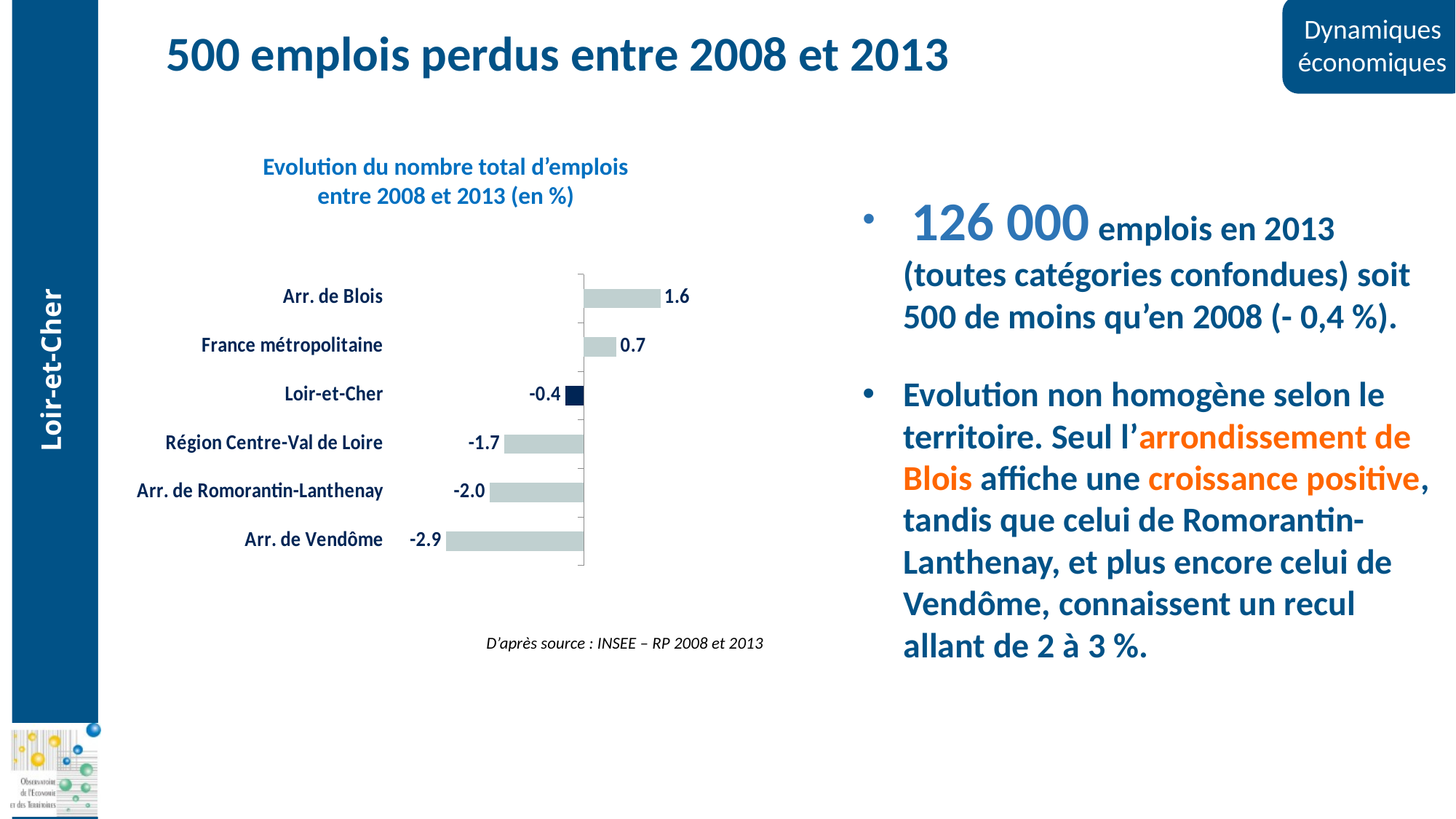
Which has the larger value, France métropolitaine or Loir-et-Cher? France métropolitaine What is the difference between the values for Arr. de Romorantin-Lanthenay and Arr. de Vendôme? 0.9 Which category has the highest value in the chart? Arr. de Blois How many categories are shown in the chart? 6 What is the title of the chart? Evolution du nombre total d'emplois entre 2008 et 2013 (en %) What kind of chart is shown on the slide? Bar chart What is the value for Arr. de Blois in the chart? 1.6 Which category has the lowest value in the chart? Arr. de Vendôme What is the value for Région Centre-Val de Loire in the chart? -1.7 What is the value for Loir-et-Cher in the chart? -0.4 What is the value for Arr. de Vendôme in the chart? -2.9 What is the difference between the values for Arr. de Blois and France métropolitaine? 0.9